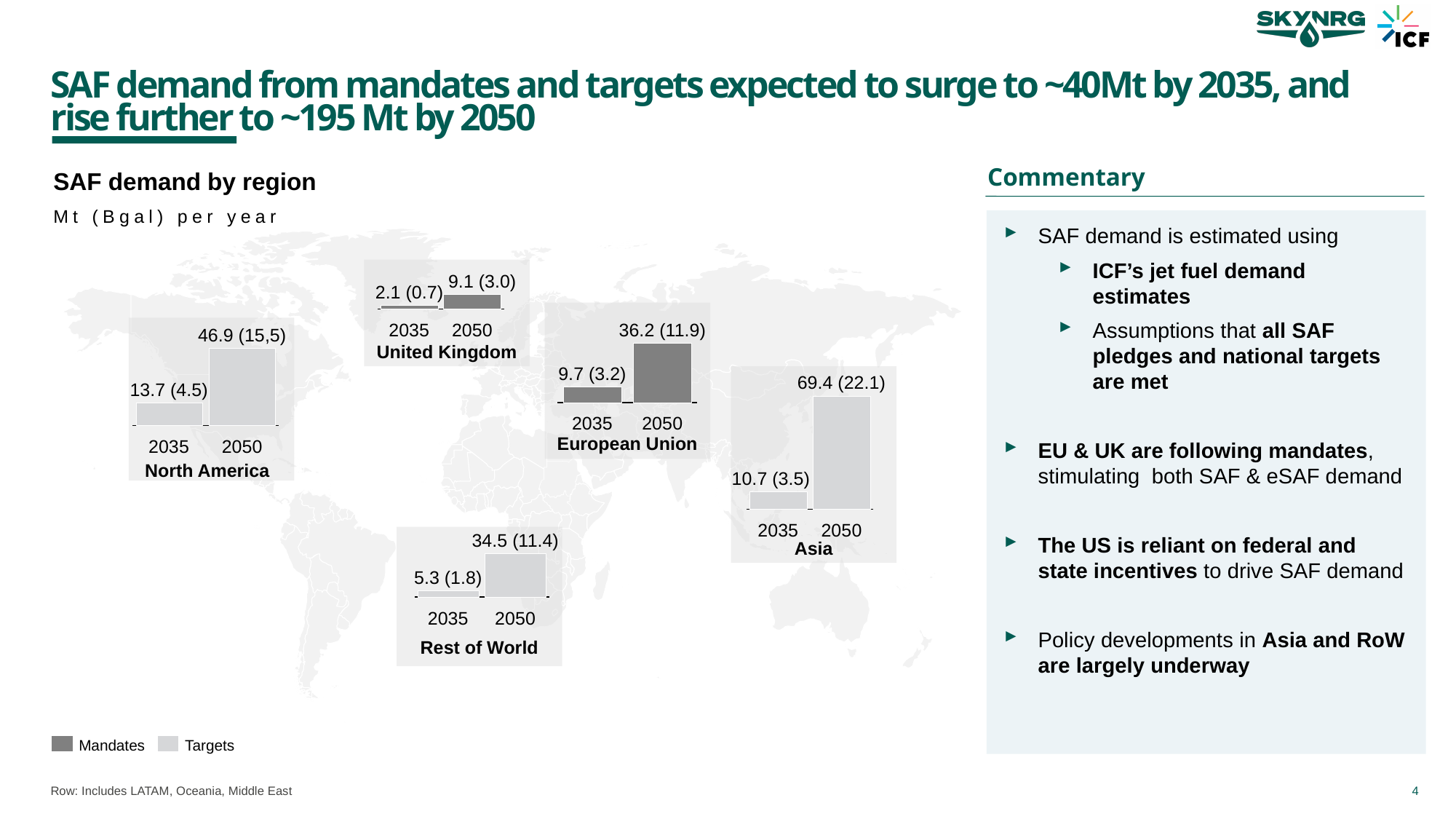
Across all the regional charts, which region has the highest 2050 SAF demand value? Asia In the Asia chart, what is the SAF demand value shown for 2050? 69.4 (22.1) In the North America chart, what is the SAF demand value shown for 2035? 13.7 (4.5) What type of chart is used to show SAF demand for each region? Bar chart How many series does the legend list for the SAF demand by region charts? 2 In the European Union chart, what is the difference in Mt between the 2050 and 2035 values? 26.5 In the Asia chart, what is the difference in Mt between the 2050 and 2035 values? 58.7 Across all the regional charts, which region has the lowest 2035 SAF demand value? United Kingdom In the United Kingdom chart, what is the SAF demand value shown for 2050? 9.1 (3.0) In the Rest of World chart, what is the SAF demand value shown for 2050? 34.5 (11.4) In the European Union chart, what is the SAF demand value shown for 2035? 9.7 (3.2) Which is larger: the 2050 value for North America or the 2050 value for the European Union? North America